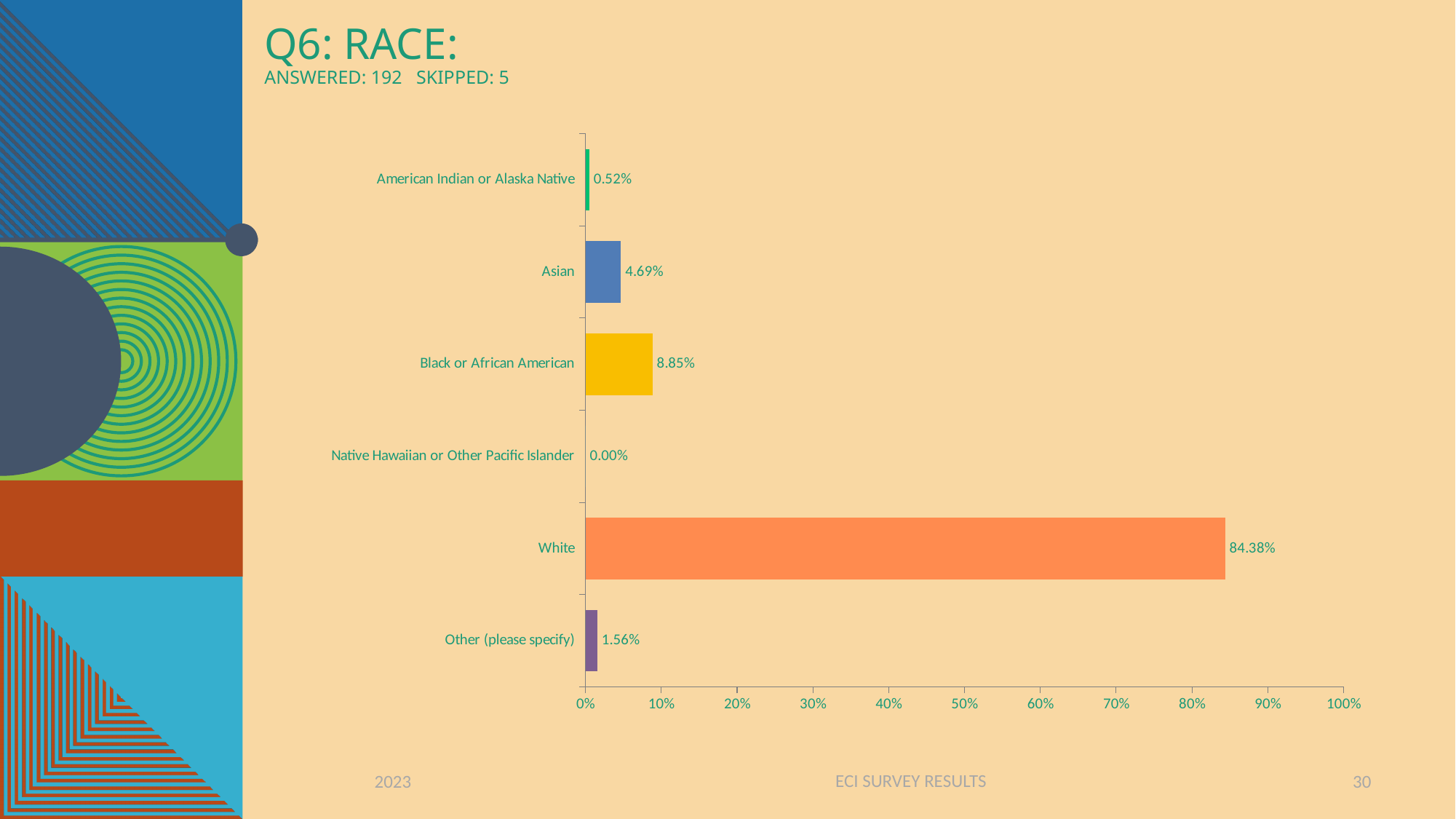
What is the difference in percentage points between Black or African American and Asian? 4.16 How many respondents answered this question according to the slide? 192 What percentage of respondents selected Black or African American? 8.85% Which race category has the highest percentage? White What type of chart is shown on the slide? bar chart Which race category has the lowest percentage? Native Hawaiian or Other Pacific Islander Is the value for White greater or less than 80%? greater Which is larger, the percentage for Other (please specify) or for American Indian or Alaska Native? Other (please specify) What percentage of respondents selected Asian? 4.69% What percentage of respondents selected Native Hawaiian or Other Pacific Islander? 0.00% What percentage of respondents selected White? 84.38% How many race categories are shown in the chart? 6